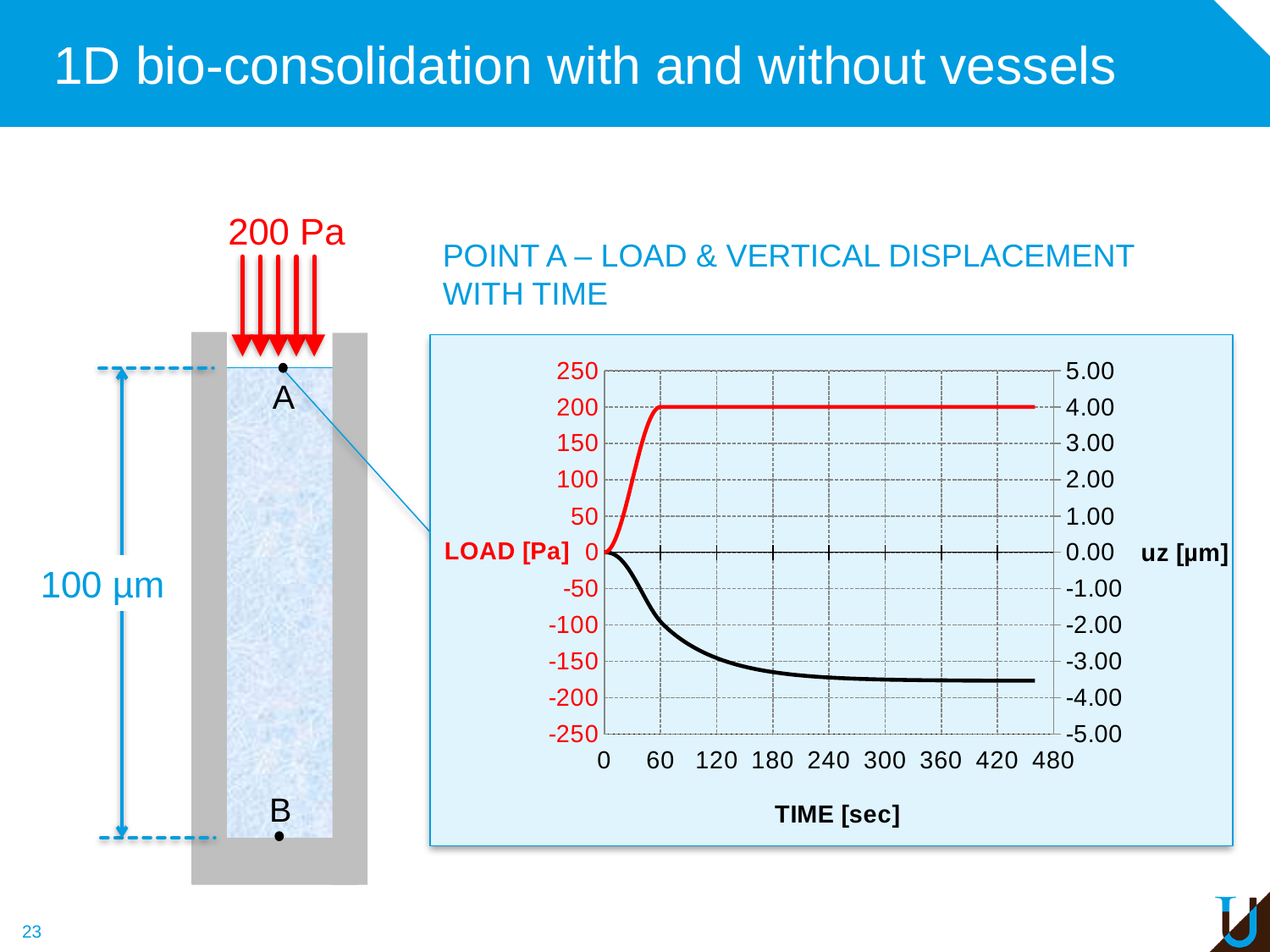
Does the red load curve rise or fall between 0 and 60 seconds? rise Does the black displacement curve rise or fall along the time axis? fall Which curve has the higher value at 240 seconds, the red load curve or the black displacement curve? the red load curve Is the value of the black displacement curve at 480 seconds greater or less than -3.00 µm? less Is the value of the black displacement curve at 480 seconds greater or less than -4.00 µm? greater What is the label of the x axis of the chart? TIME [sec] What is the label of the left y axis of the chart? LOAD [Pa] What is the maximum value shown on the left LOAD [Pa] axis? 250 What is the plateau value of the red load curve after about 60 seconds? 200 How many curves are plotted on the chart? 2 What kind of chart is shown on the slide? line chart